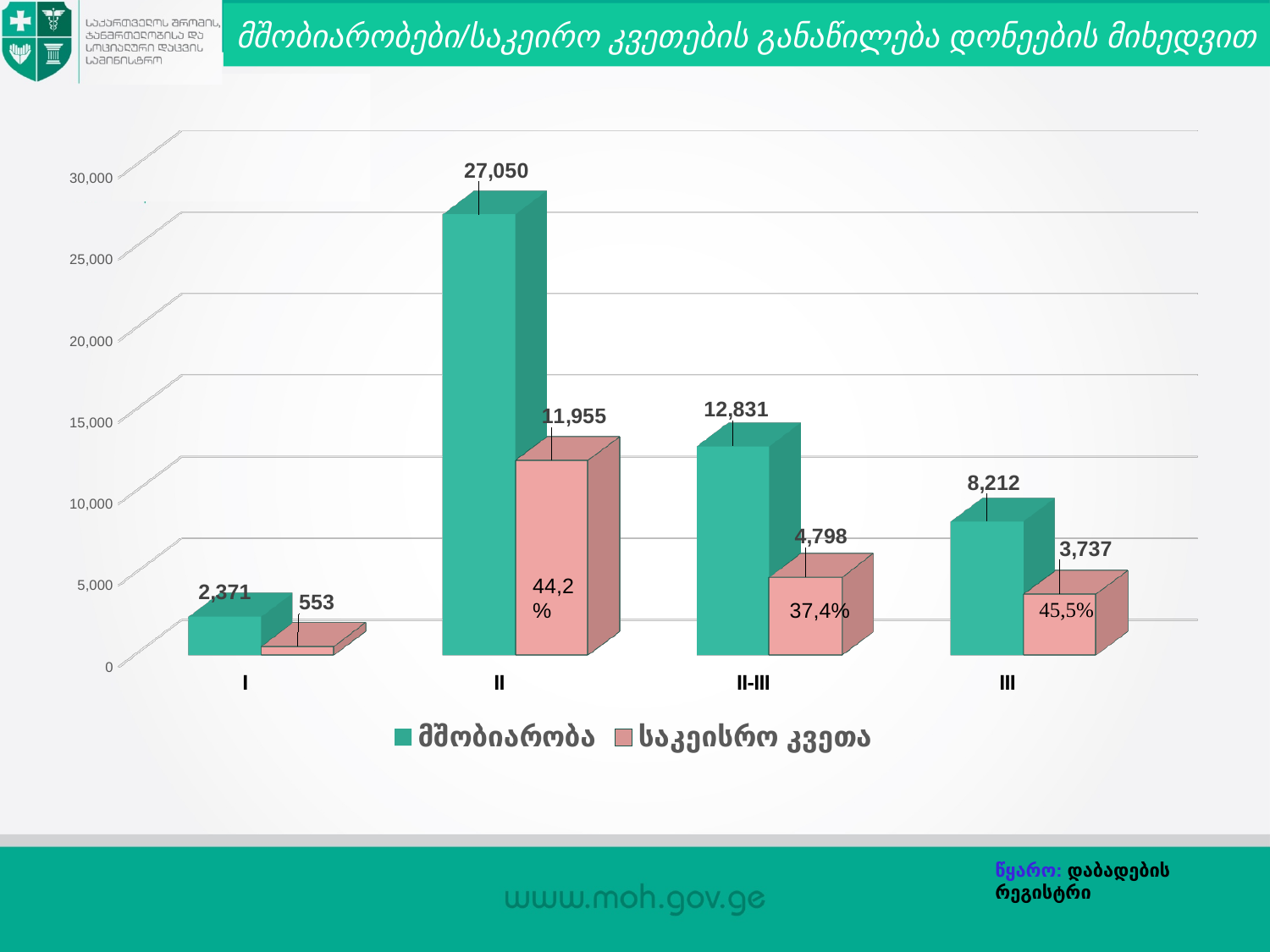
Which level has the highest მშობიარობა value? II What is the value of მშობიარობა for level III? 8,212 What percentage label is shown inside the საკეისრო კვეთა bar for level III? 45,5% What is the value of მშობიარობა for level II? 27,050 How many levels are shown on the x axis? 4 What is the value of საკეისრო კვეთა for level II-III? 4,798 How many series does the legend list? 2 Which is larger: საკეისრო კვეთა for level II-III or for level III? II-III What is the difference between მშობიარობა and საკეისრო კვეთა for level II? 15,095 Which level has the lowest საკეისრო კვეთა value? I What kind of chart is shown on the slide? bar chart What is the value of საკეისრო კვეთა for level I? 553